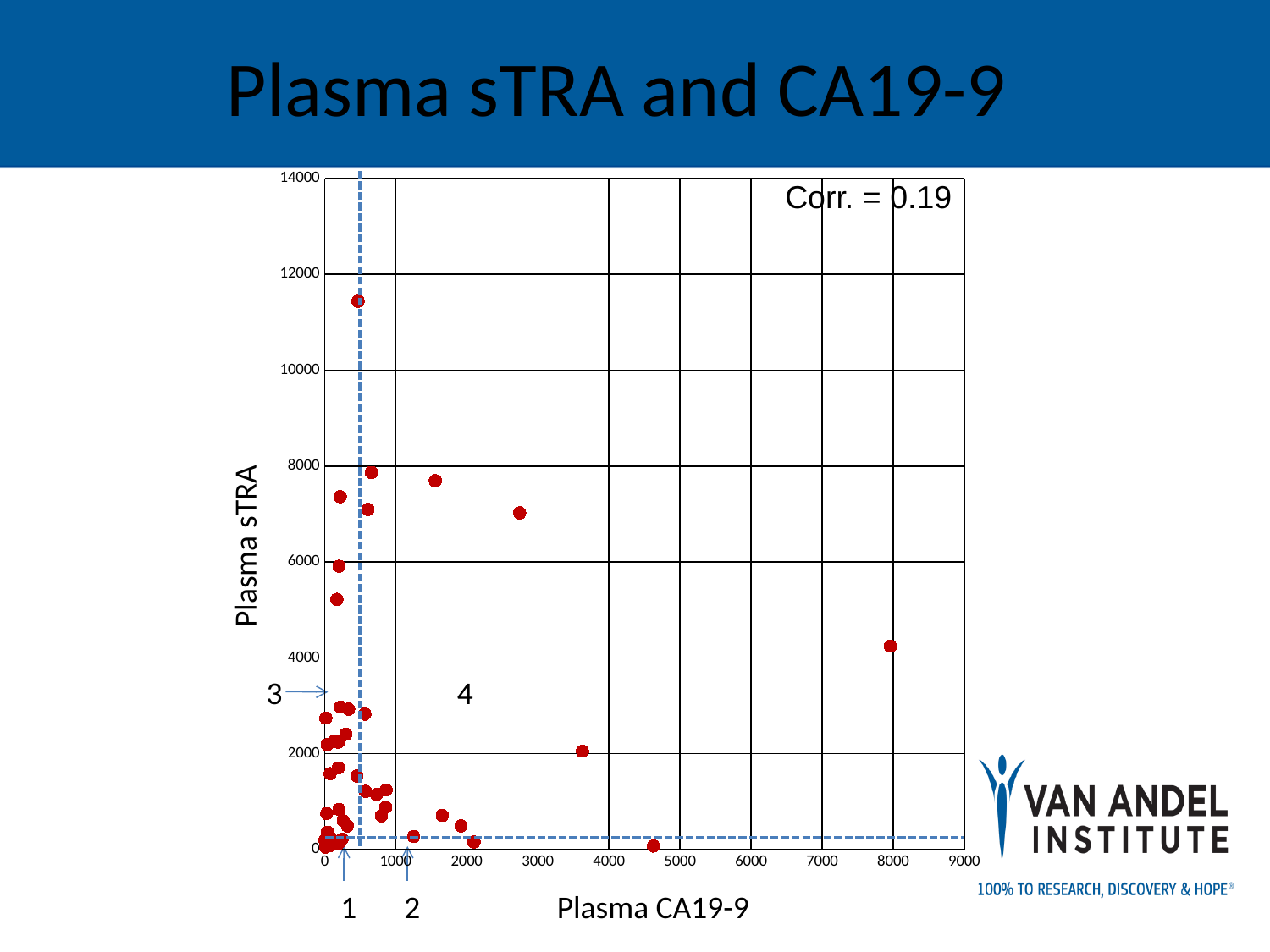
Is the highest Plasma sTRA value plotted greater or less than 10000? greater What kind of chart is shown on the slide? scatter plot What is the title of the chart? Plasma sTRA and CA19-9 What is the largest tick value shown on the horizontal axis? 9000 What is the label of the vertical axis? Plasma sTRA What correlation value is printed on the chart? 0.19 What is the largest tick value shown on the vertical axis? 14000 Is the highest Plasma CA19-9 value plotted greater or less than 7000? greater Is the Plasma sTRA value of the point near 3600 on the Plasma CA19-9 axis greater or less than 4000? less